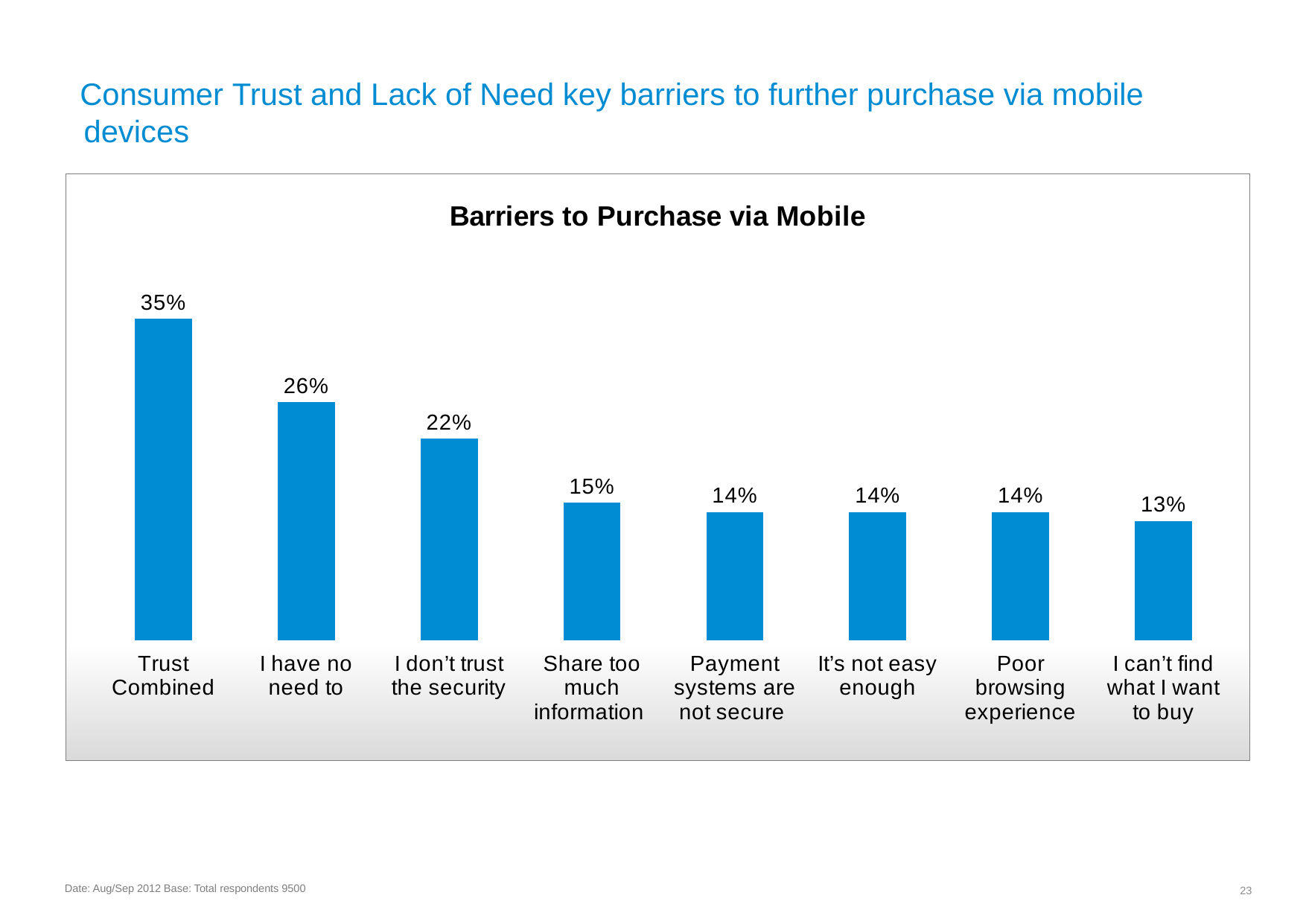
What is the value for "I have no need to"? 26% Which barrier has the highest value? Trust Combined How many barriers are shown in the chart? 8 What is the value for "Share too much information"? 15% Which is larger, "I don't trust the security" or "Share too much information"? I don't trust the security What is the difference between "Trust Combined" and "I have no need to"? 9% What kind of chart is this? Bar chart What is the title of the chart? Barriers to Purchase via Mobile Which barrier has the lowest value? I can't find what I want to buy What is the value for "I don't trust the security"? 22% What is the value for "Trust Combined"? 35% What is the value for "I can't find what I want to buy"? 13%